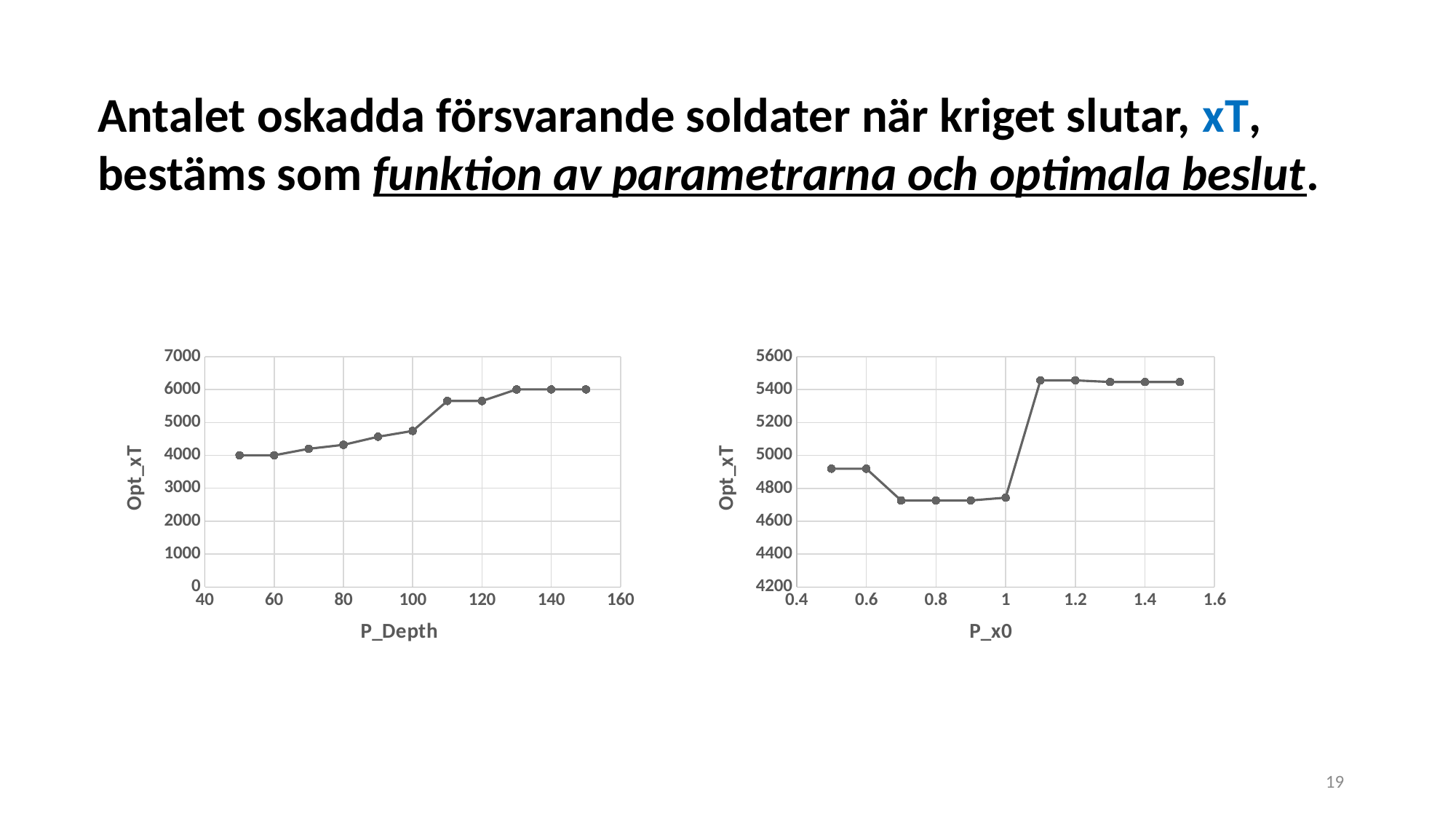
In the right chart (P_x0), is the value of Opt_xT at P_x0 = 0.8 greater or less than 4800? less In the left chart (P_Depth), do the Opt_xT values generally rise or fall as P_Depth increases? rise In the right chart (P_x0), is the value of Opt_xT at P_x0 = 1.2 greater or less than 5200? greater In the right chart (P_x0), which has the larger Opt_xT value: P_x0 = 0.6 or P_x0 = 0.7? P_x0 = 0.6 What is the x-axis title of the left chart? P_Depth In the right chart (P_x0), how many data points are plotted? 11 In the left chart (P_Depth), is the value of Opt_xT at P_Depth = 80 greater or less than 5000? less In the left chart (P_Depth), how many data points are plotted? 11 In the left chart (P_Depth), which has the larger Opt_xT value: P_Depth = 100 or P_Depth = 110? P_Depth = 110 What kind of chart is the left chart with x axis P_Depth? line chart What is the y-axis title of the right chart? Opt_xT